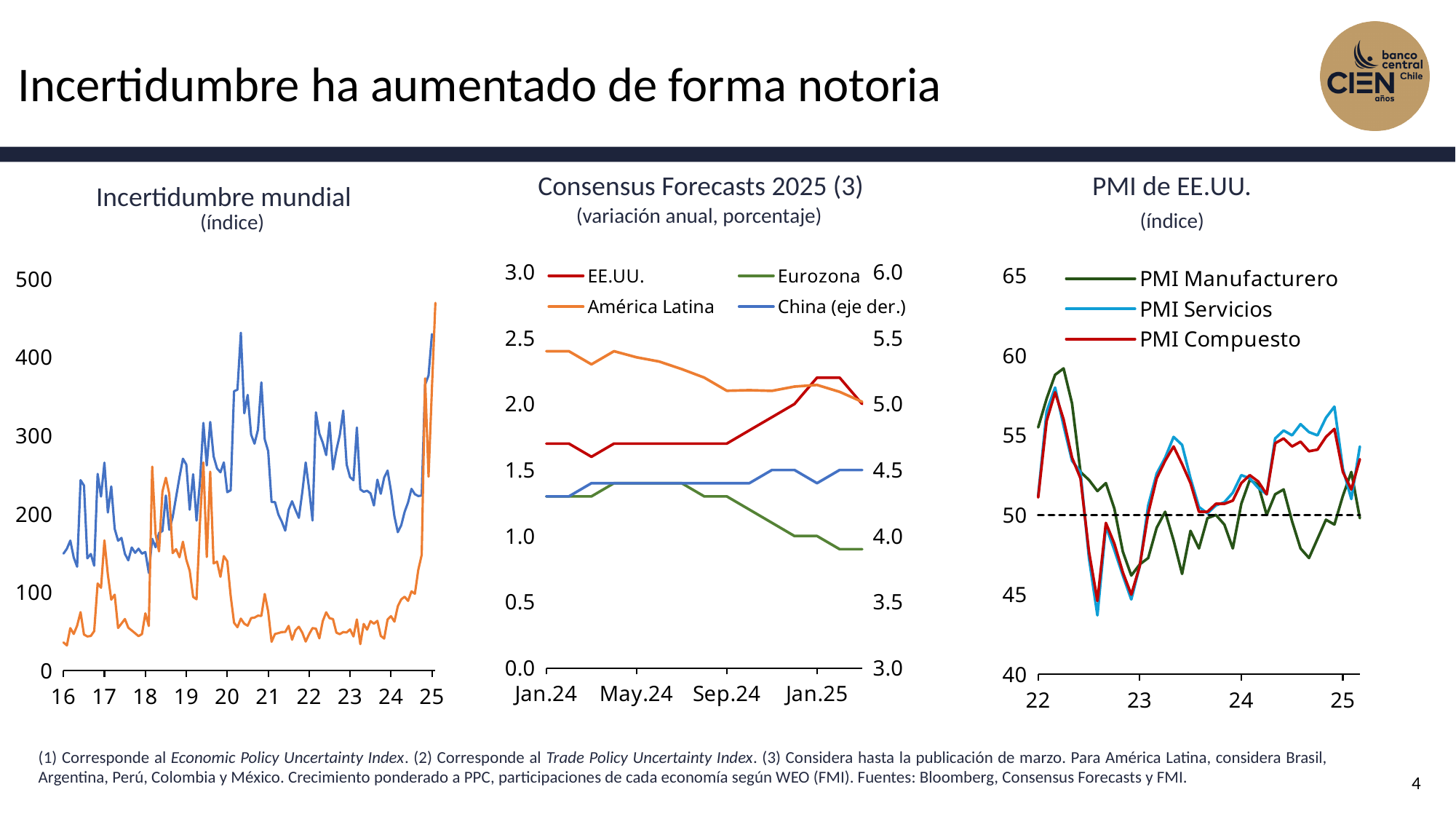
In the 'Consensus Forecasts 2025 (3)' chart, is the value for EE.UU. at Jan.24 greater or less than 2.0? less In the 'Consensus Forecasts 2025 (3)' chart, at Jan.24, which is higher, América Latina or EE.UU.? América Latina In the 'Consensus Forecasts 2025 (3)' chart, does the Eurozona series rise or fall from Jan.24 to Jan.25? fall In the 'Incertidumbre mundial' chart, is the final value of the orange series at 25 greater or less than 400? greater How many series does the legend of the 'PMI de EE.UU.' chart list? 3 How many series does the legend of the 'Consensus Forecasts 2025 (3)' chart list? 4 In the 'PMI de EE.UU.' chart, is the lowest value of PMI Servicios greater or less than 45? less What kind of chart is the 'PMI de EE.UU.' chart? line chart In the 'Consensus Forecasts 2025 (3)' chart, does the EE.UU. series rise or fall from Jan.24 to Jan.25? rise In the 'Consensus Forecasts 2025 (3)' chart, which series is plotted on the right-hand axis? China (eje der.) In the 'PMI de EE.UU.' chart, at what level is the dashed horizontal line drawn? 50